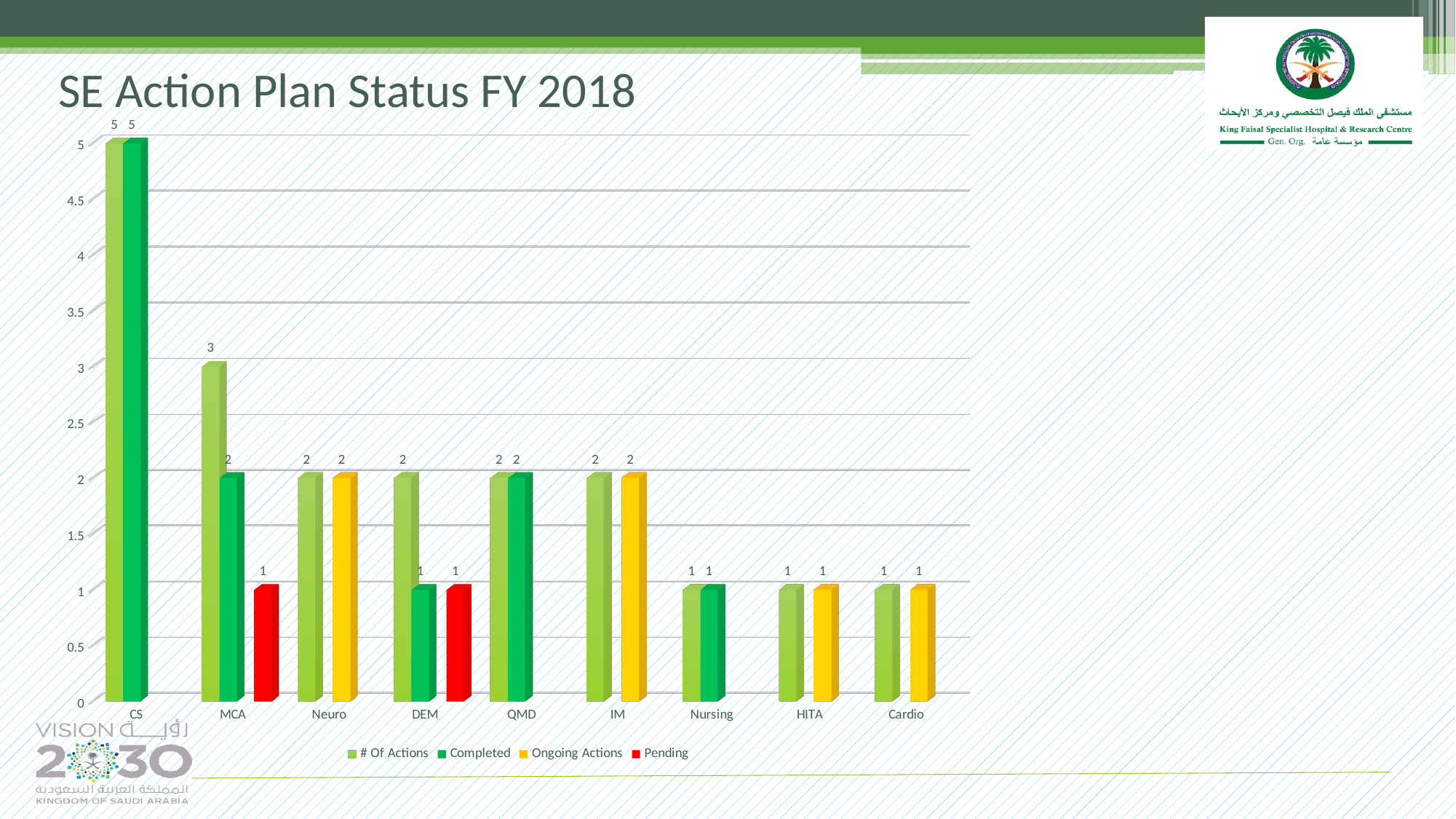
What is the Pending value for DEM? 1 What is the title of the chart? SE Action Plan Status FY 2018 How many series does the legend list? 4 Which category has the highest # Of Actions value? CS How many categories are shown on the x axis? 9 What is the # Of Actions value for CS? 5 What is the Ongoing Actions value for IM? 2 Which categories have a Pending bar? MCA and DEM What is the Completed value for MCA? 2 What is the difference between the # Of Actions value and the Completed value for MCA? 1 What type of chart is shown on the slide? Bar chart Which is larger, the # Of Actions value for MCA or the # Of Actions value for Neuro? MCA